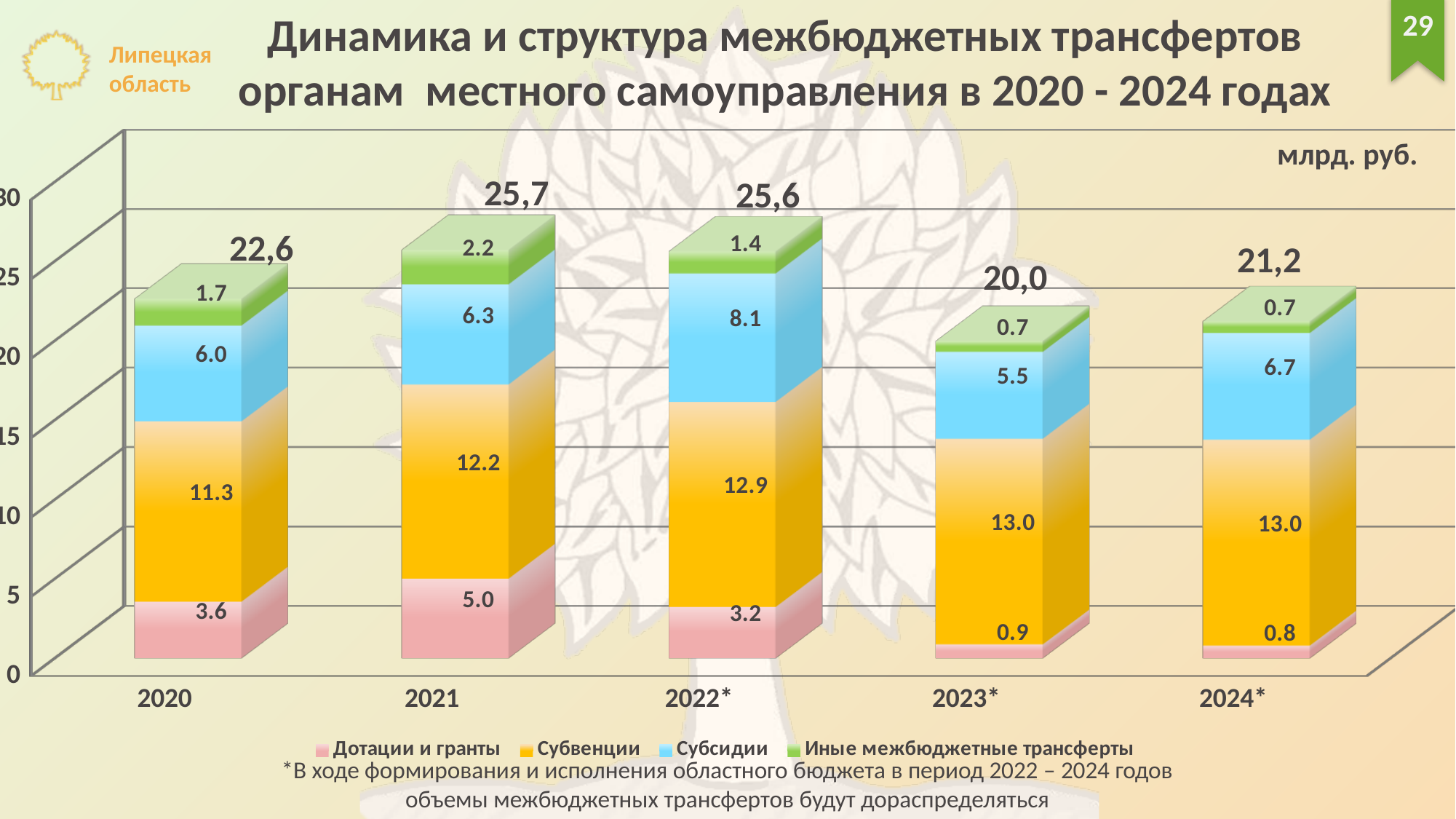
How many years (categories) are shown on the x axis? 5 What is the value of Субсидии in 2022*? 8.1 What is the difference between the Субсидии values in 2022* and 2023*? 2.6 What unit of measurement is indicated on the chart? млрд. руб. How many series does the legend list? 4 What type of chart is shown on the slide? Stacked bar chart Which is larger: Иные межбюджетные трансферты in 2021 or in 2022*? 2021 What is the total of the stacked bar for 2023*? 20,0 What is the value of Дотации и гранты in 2024*? 0.8 What is the value of Субвенции in 2021? 12.2 Which year has the highest total of intergovernmental transfers? 2021 Which year has the lowest total of intergovernmental transfers? 2023*